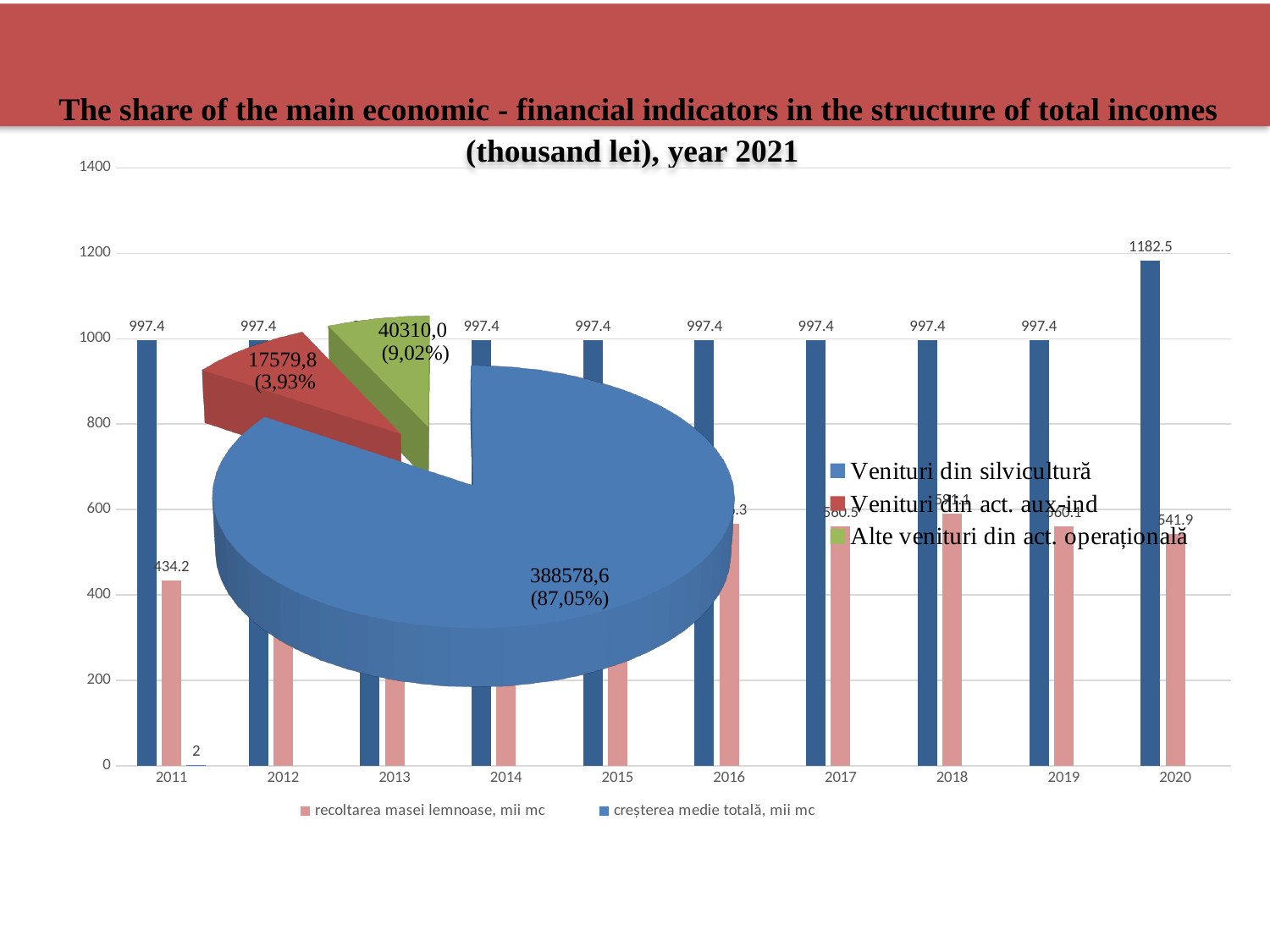
In the bar chart behind the pie, what is the value of recoltarea masei lemnoase, mii mc for 2011? 434.2 In the bar chart behind the pie, which year has the highest value of creșterea medie totală, mii mc? 2020 In the pie chart, what is the value for Venituri din act. aux-ind? 17579,8 In the bar chart behind the pie, is recoltarea masei lemnoase, mii mc larger in 2020 or in 2011? 2020 In the pie chart, what share does Alte venituri din act. operațională represent? 9,02% In the bar chart behind the pie, what is the value of creșterea medie totală, mii mc for 2020? 1182.5 In the bar chart behind the pie, what is the difference between creșterea medie totală, mii mc in 2020 and in 2019? 185.1 How many series does the legend of the bar chart behind the pie list? 2 In the pie chart, what share of total incomes does Venituri din silvicultură represent? 87,05% In the pie chart, what is the value for Venituri din silvicultură? 388578,6 How many slices does the pie chart have? 3